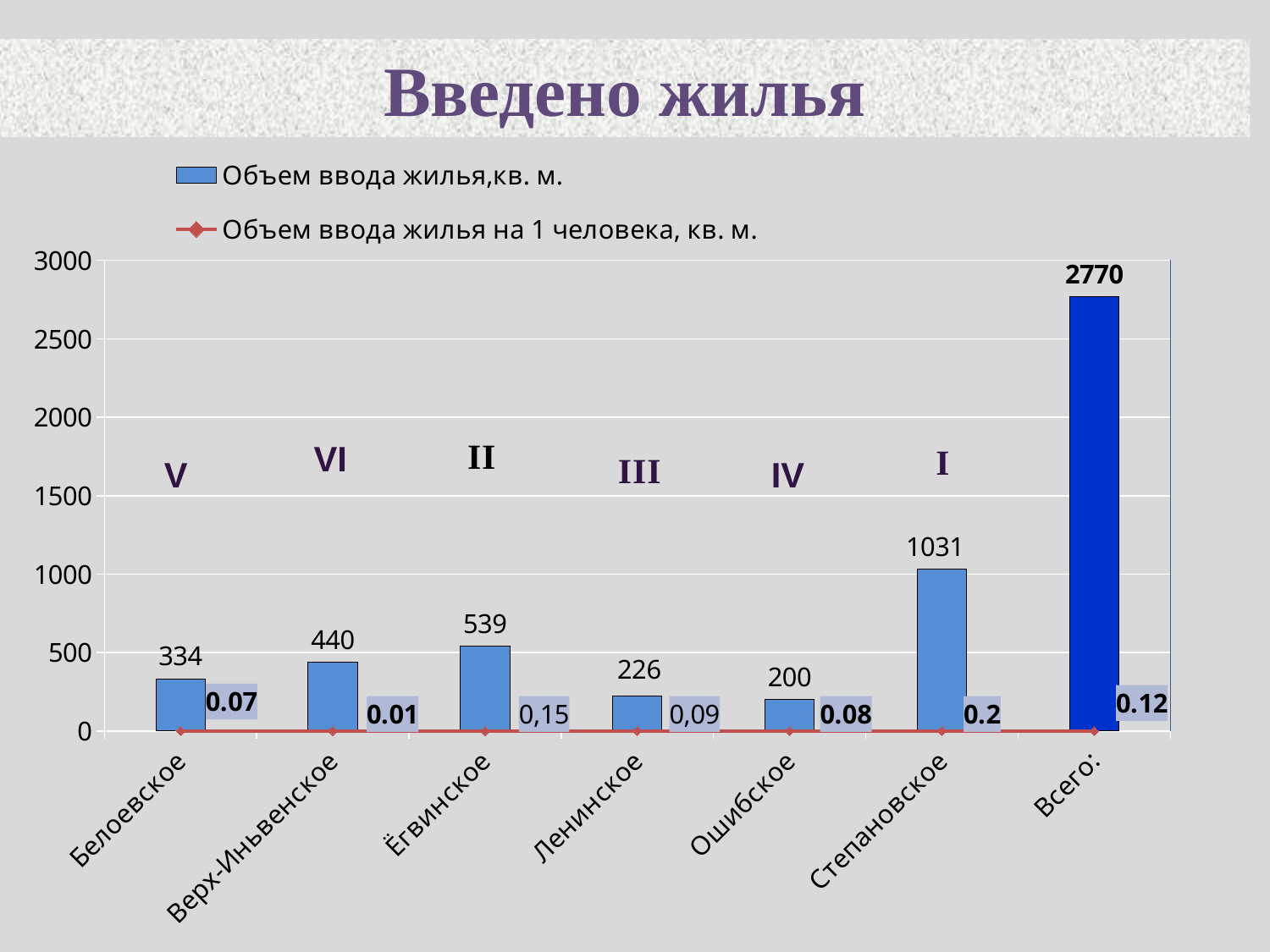
What is the value of "Объем ввода жилья на 1 человека, кв. м." for Всего:? 0.12 What is the value of "Объем ввода жилья на 1 человека, кв. м." for Ёгвинское? 0,15 What is the value of "Объем ввода жилья,кв. м." for Степановское? 1031 Which has a larger "Объем ввода жилья,кв. м." value, Белоевское or Ленинское? Белоевское What is the value of "Объем ввода жилья,кв. м." for Ленинское? 226 Which category has the lowest value of "Объем ввода жилья,кв. м."? Ошибское How many series does the chart legend list? 2 What is the title of the slide containing the chart? Введено жилья Excluding the Всего: total, which category has the highest value of "Объем ввода жилья,кв. м."? Степановское How many categories are shown on the x axis of the chart? 7 Is the "Объем ввода жилья,кв. м." value for Степановское greater or less than 1000? greater What is the difference between the "Объем ввода жилья,кв. м." values for Ёгвинское and Верх-Иньвенское? 99